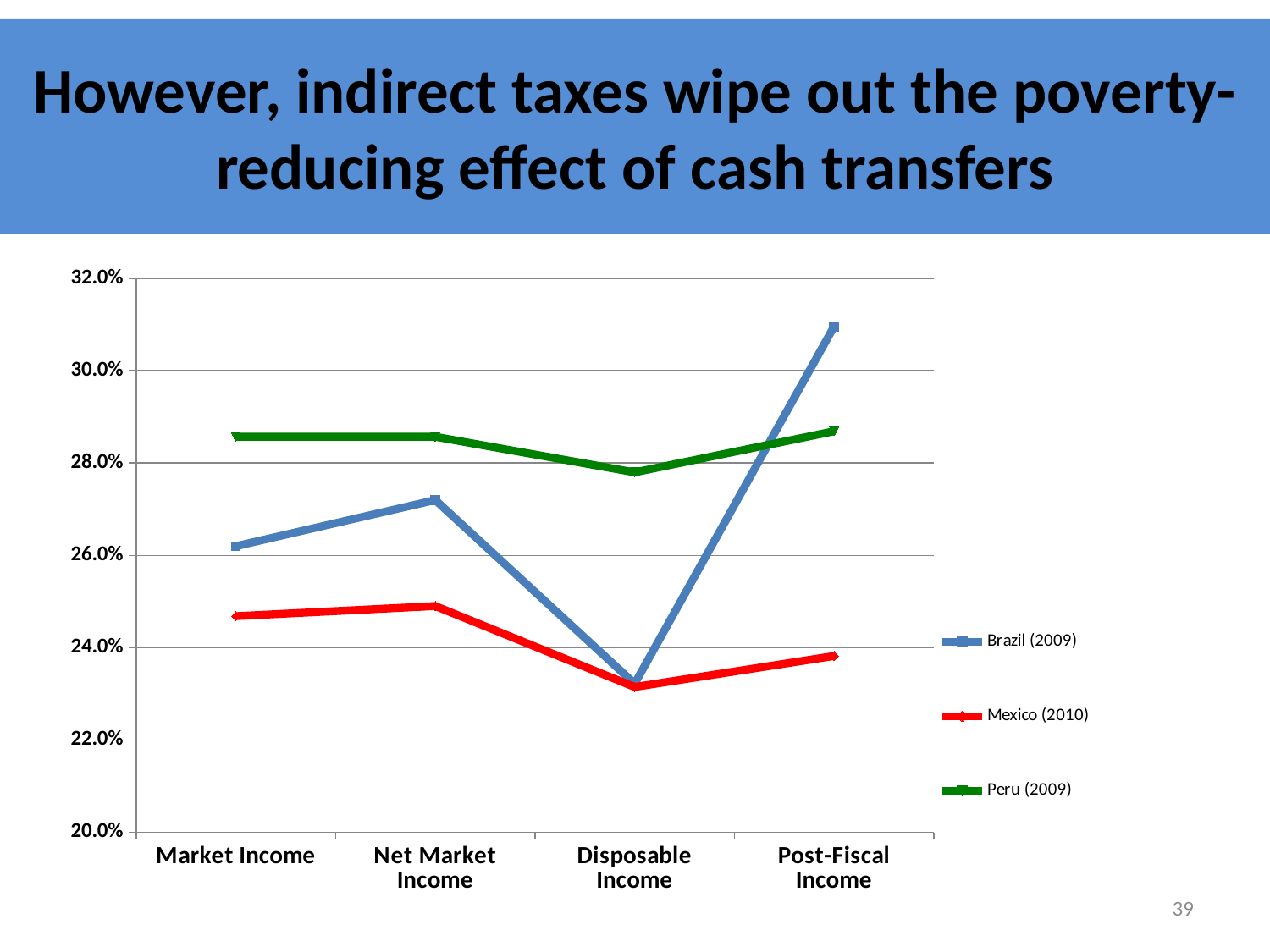
At which income category does Brazil (2009) reach its highest value? Post-Fiscal Income How many income categories are shown on the x axis? 4 Which series has the lowest value at Market Income? Mexico (2010) How many series does the legend list? 3 Which series has the highest value at Post-Fiscal Income? Brazil (2009) Is the value for Brazil (2009) at Post-Fiscal Income greater or less than 30.0%? greater Which is larger at Market Income: Peru (2009) or Mexico (2010)? Peru (2009) Is the value for Mexico (2010) at Disposable Income greater or less than 24.0%? less What kind of chart is shown on the slide? Line chart Does the Brazil (2009) line rise or fall from Net Market Income to Disposable Income? Fall What colour is the line for Peru (2009)? Green At which income category does Brazil (2009) reach its lowest value? Disposable Income